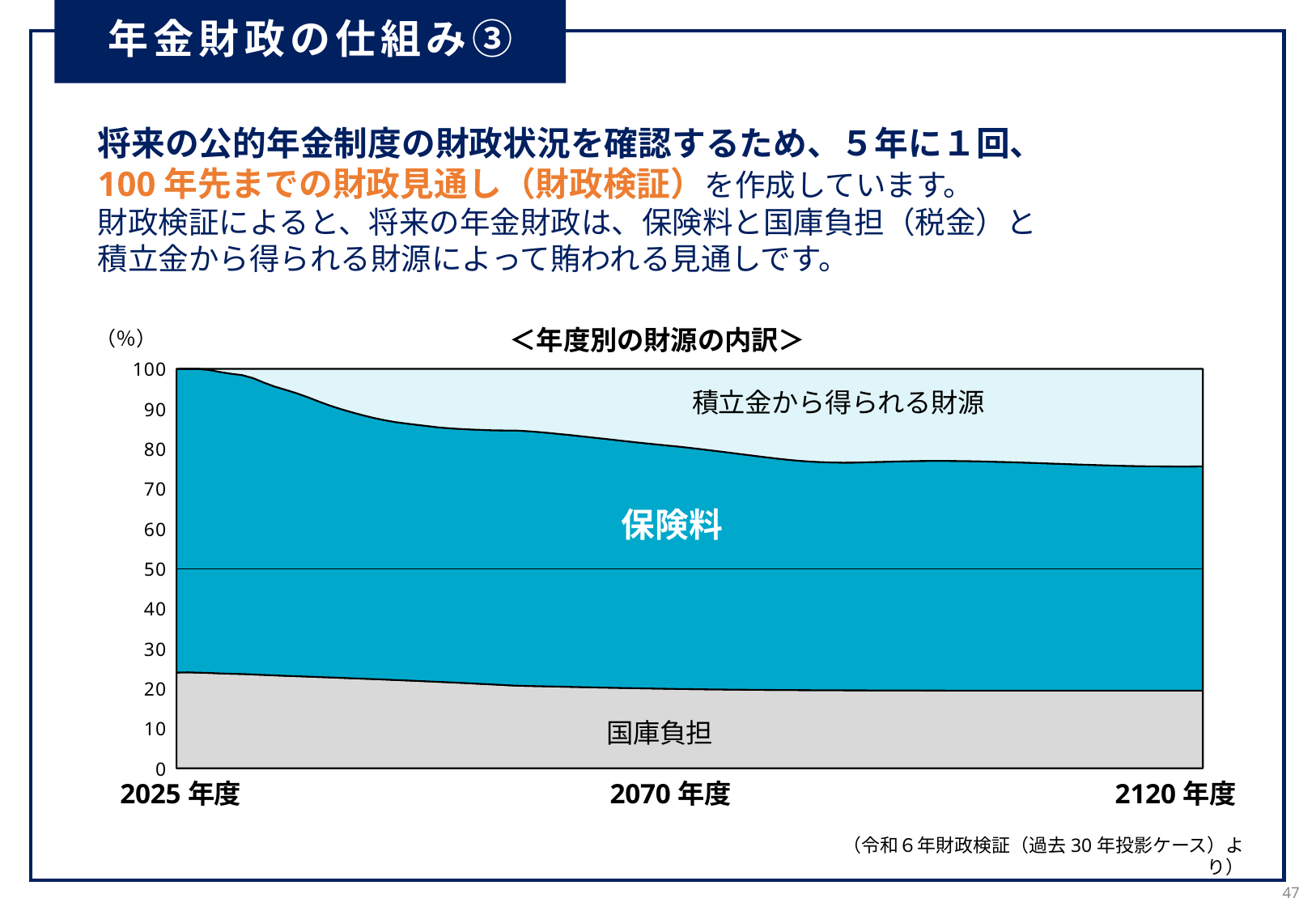
Which funding source occupies the bottom (gray) area of the chart? 国庫負担 Does the share of 国庫負担 rise or fall from 2025年度 to 2120年度? fall How many funding sources (areas) are shown in the chart? 3 Is the share of 積立金から得られる財源 in 2120年度 greater or less than 10%? greater Which funding source has the largest share across all years shown? 保険料 Is the share of 国庫負担 in 2025年度 greater or less than 20%? greater What is the title of the chart? ＜年度別の財源の内訳＞ What kind of chart is shown under the title ＜年度別の財源の内訳＞? Stacked area chart Does the share of 積立金から得られる財源 rise or fall from 2025年度 to 2120年度? rise Is the combined share of 国庫負担 and 保険料 in 2120年度 greater or less than 80%? less What unit is shown on the vertical axis of the chart? % In 2120年度, which is larger: the share of 保険料 or the share of 国庫負担? 保険料